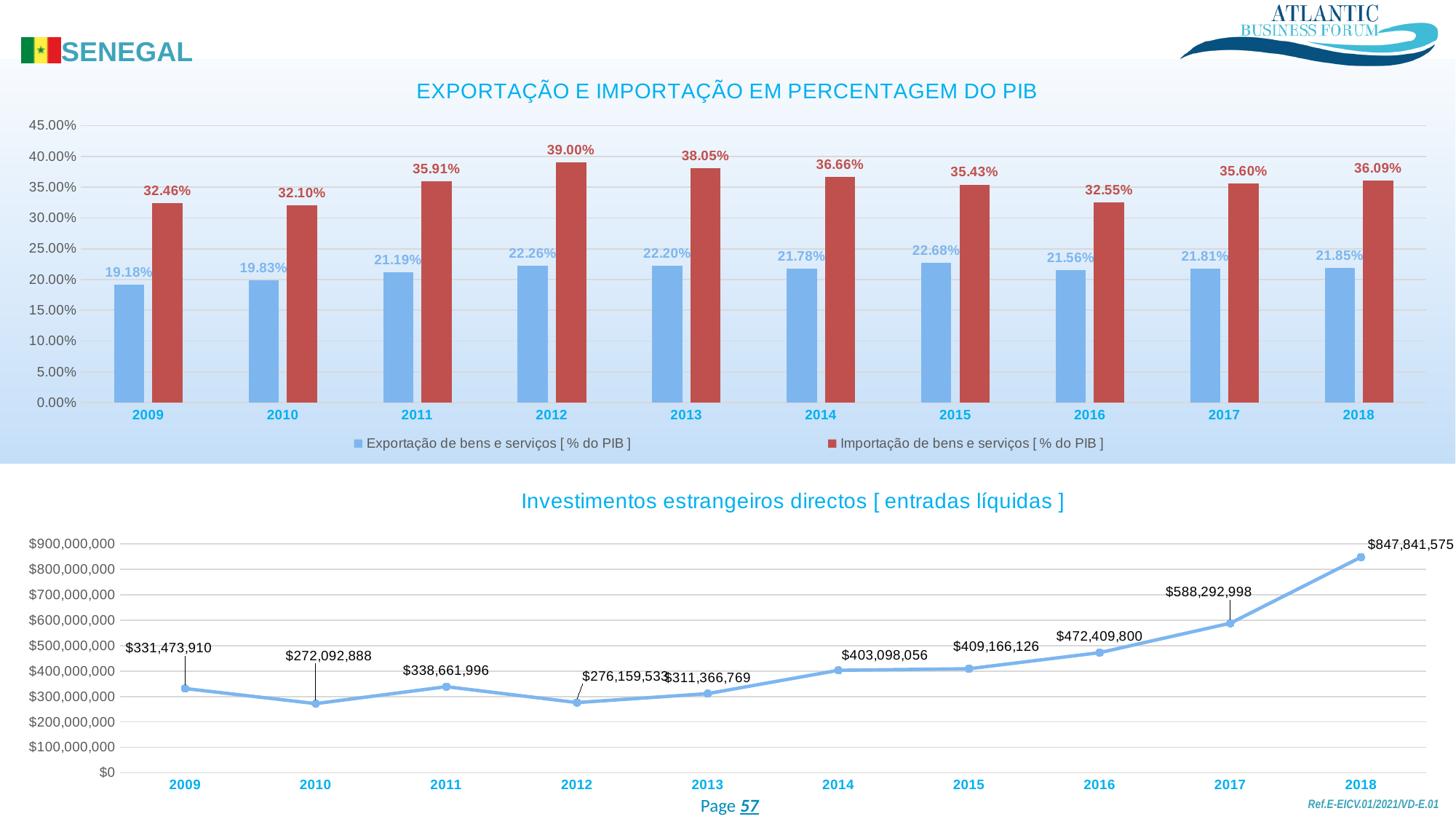
What kind of chart is the top chart (EXPORTAÇÃO E IMPORTAÇÃO EM PERCENTAGEM DO PIB)? Bar chart In the top chart (EXPORTAÇÃO E IMPORTAÇÃO EM PERCENTAGEM DO PIB), what is the value of Importação de bens e serviços for 2012? 39.00% In the bottom chart (Investimentos estrangeiros directos), what is the difference between the 2018 and 2017 values? $259,548,577 In the top chart (EXPORTAÇÃO E IMPORTAÇÃO EM PERCENTAGEM DO PIB), which year has the lowest Exportação value? 2009 In the bottom chart (Investimentos estrangeiros directos), do the values rise or fall from 2014 to 2018? Rise In the top chart (EXPORTAÇÃO E IMPORTAÇÃO EM PERCENTAGEM DO PIB), which year has the highest Importação value? 2012 In the top chart (EXPORTAÇÃO E IMPORTAÇÃO EM PERCENTAGEM DO PIB), what is the difference between Importação and Exportação in 2012? 16.74% In the top chart (EXPORTAÇÃO E IMPORTAÇÃO EM PERCENTAGEM DO PIB), what is the value of Exportação de bens e serviços for 2009? 19.18% In the top chart (EXPORTAÇÃO E IMPORTAÇÃO EM PERCENTAGEM DO PIB), how many series does the legend list? 2 In the bottom chart (Investimentos estrangeiros directos), how many years are plotted? 10 In the bottom chart (Investimentos estrangeiros directos), which year has the lowest value? 2010 In the bottom chart (Investimentos estrangeiros directos), what is the value for 2018? $847,841,575